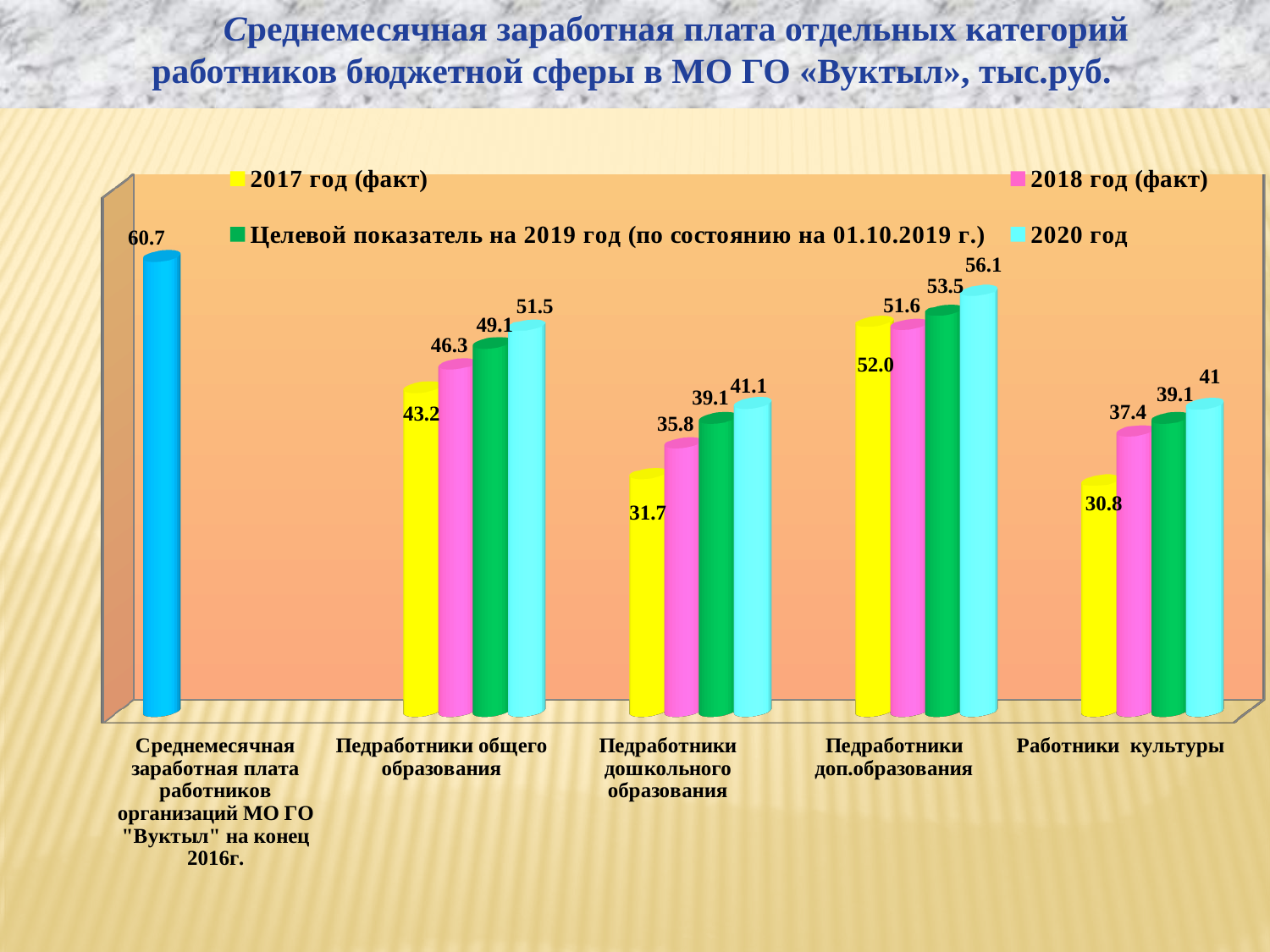
Which is larger for Педработники доп.образования: the 2017 год (факт) value or the 2018 год (факт) value? 2017 год (факт) Which category has the highest value in the 2020 год series? Педработники доп.образования What is the value for Педработники дошкольного образования in the 2020 год series? 41.1 What is the value shown for Среднемесячная заработная плата работников организаций МО ГО "Вуктыл" на конец 2016г.? 60.7 What is the value for Педработники общего образования in the 2017 год (факт) series? 43.2 How many series does the legend list? 4 Which category has the lowest value in the 2017 год (факт) series? Работники культуры Do the values for Работники культуры rise or fall from 2017 год (факт) to 2020 год? Rise What kind of chart is shown on the slide? Bar chart What is the value for Педработники доп.образования in the Целевой показатель на 2019 год series? 53.5 What is the difference between the 2020 год value and the 2017 год (факт) value for Педработники дошкольного образования? 9.4 What is the value for Работники культуры in the 2018 год (факт) series? 37.4